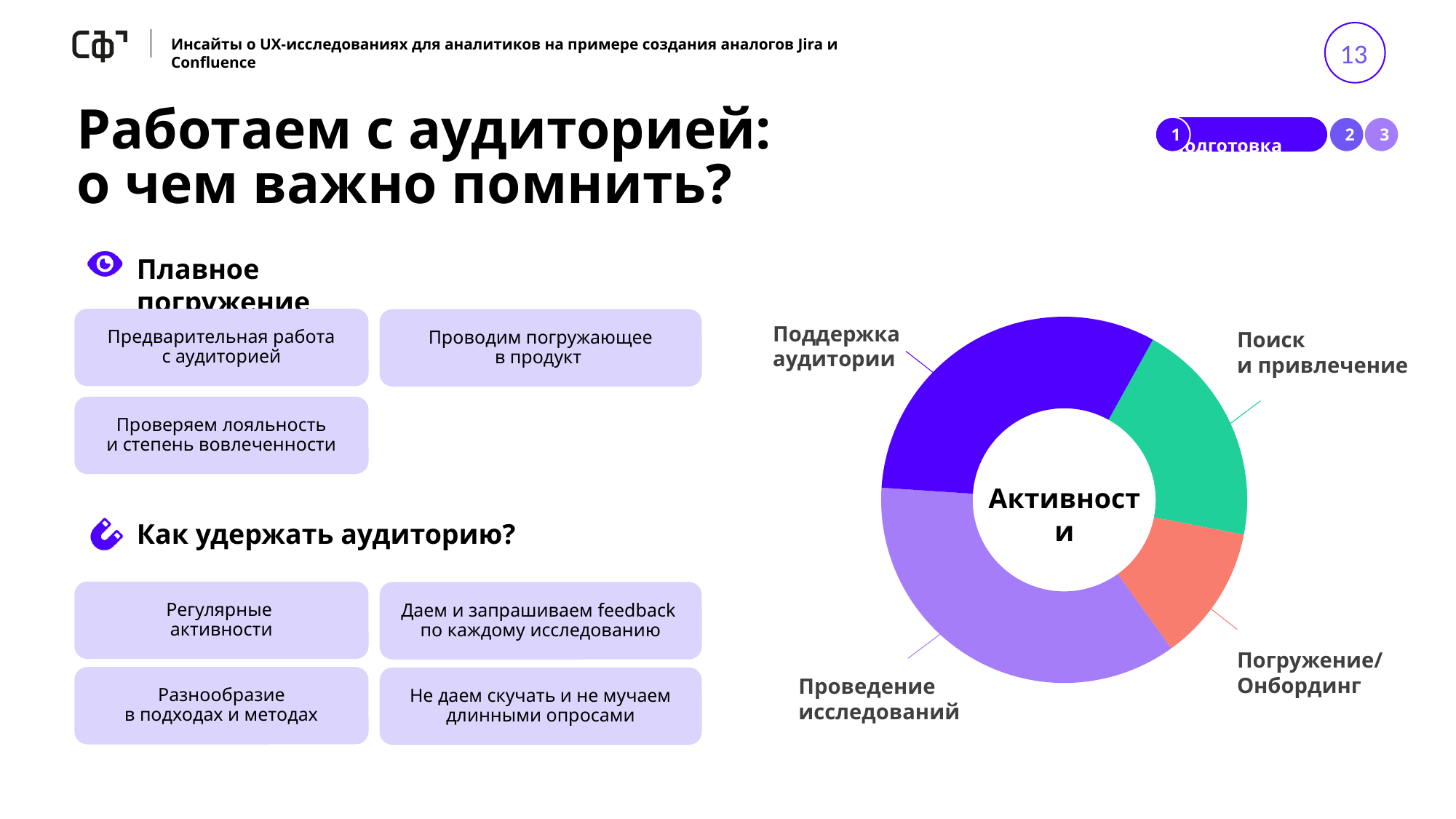
Which segment is larger: Поиск и привлечение or Погружение/Онбординг? Поиск и привлечение Which segment of the donut chart is the largest? Проведение исследований Which segment is larger: Поддержка аудитории or Поиск и привлечение? Поддержка аудитории How many segments does the donut chart have? 4 Which segment is larger: Проведение исследований or Погружение/Онбординг? Проведение исследований Which segment of the donut chart is the smallest? Погружение/Онбординг What kind of chart is shown on the slide? donut chart What colour is the Поиск и привлечение segment of the donut chart? green What word is written in the centre of the donut chart? Активности